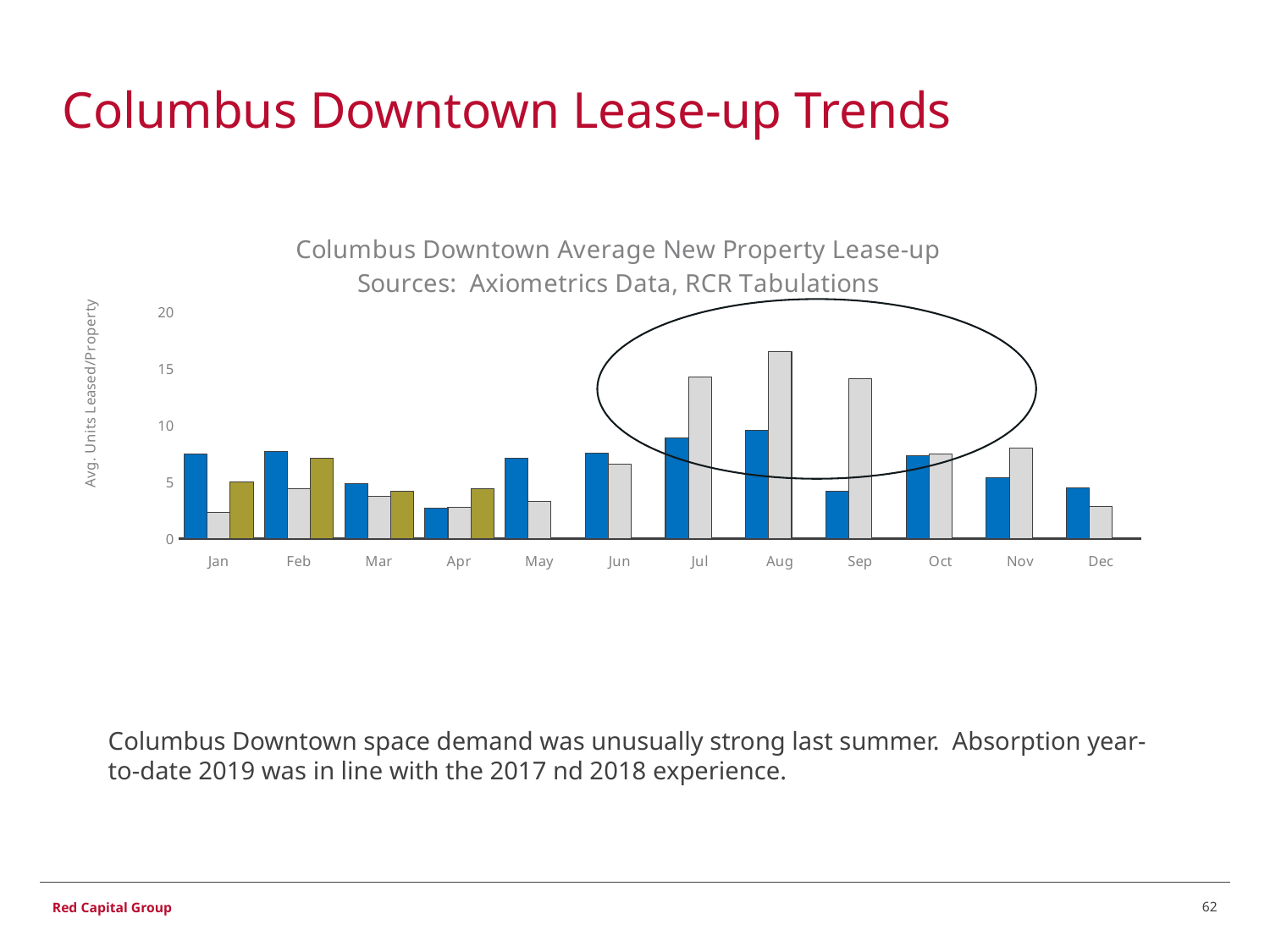
In Aug, which bar is taller, the blue bar or the gray bar? gray Is the gray bar for Jul greater or less than 15? less Is the gray bar for Aug greater or less than 15? greater What kind of chart is shown on the slide? bar chart In which month is the gray bar the tallest? Aug What is the label on the vertical axis of the chart? Avg. Units Leased/Property What is the title of the chart? Columbus Downtown Average New Property Lease-up Sources: Axiometrics Data, RCR Tabulations In which month is the blue bar the shortest? Apr How many months are shown along the x axis of the chart? 12 Is the blue bar for Jan greater or less than 5? greater